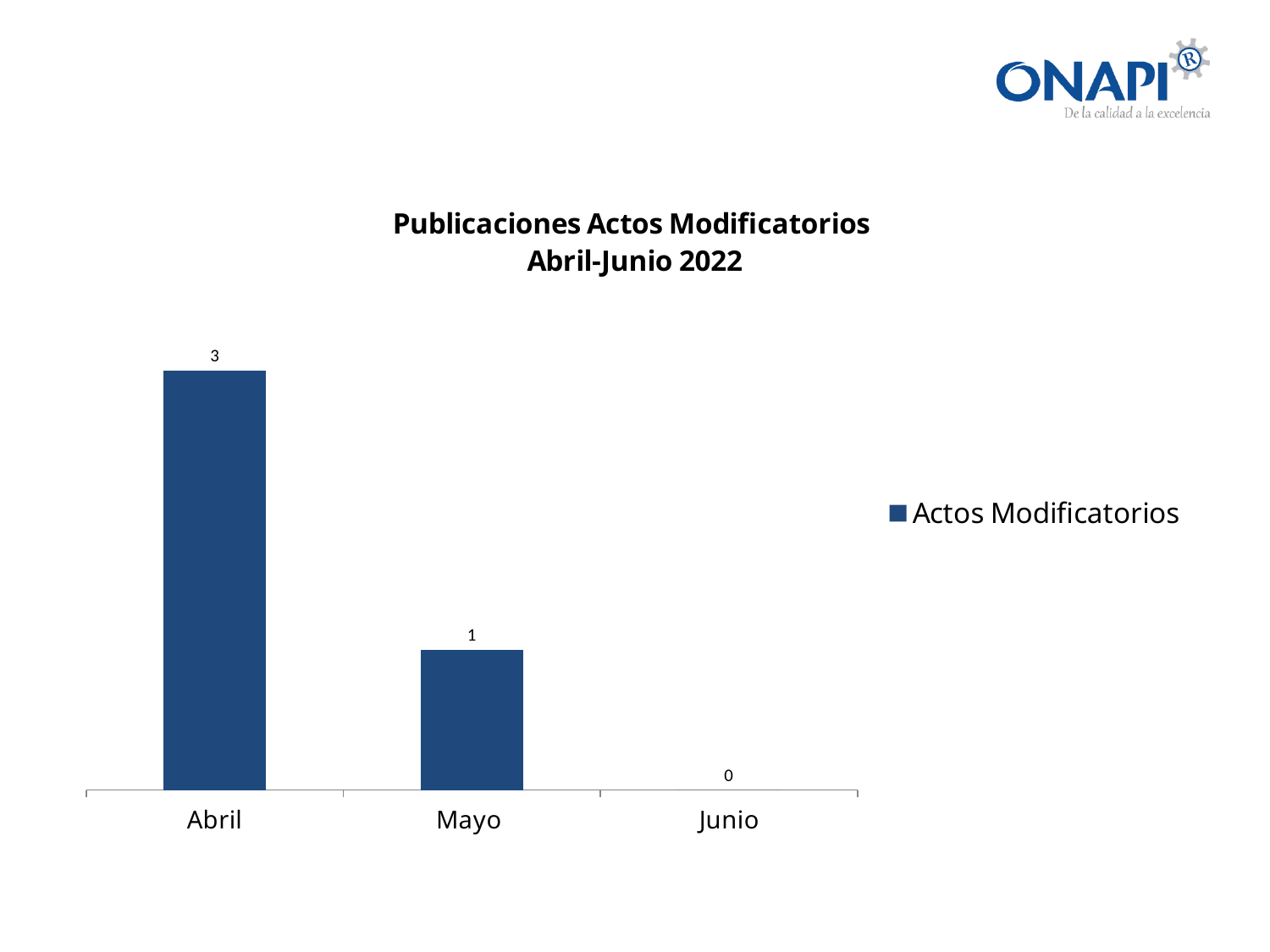
What is the title of the chart? Publicaciones Actos Modificatorios Abril-Junio 2022 What is the difference between the values for Abril and Mayo? 2 Which is larger, the value for Mayo or the value for Junio? Mayo What is the value for Mayo? 1 What is the value for Junio? 0 How many months are shown on the x axis? 3 What kind of chart is shown? Bar chart How many series does the legend list? 1 What is the value for Abril? 3 Do the values rise or fall from Abril to Junio? Fall Which month has the lowest value? Junio Which month has the highest value? Abril